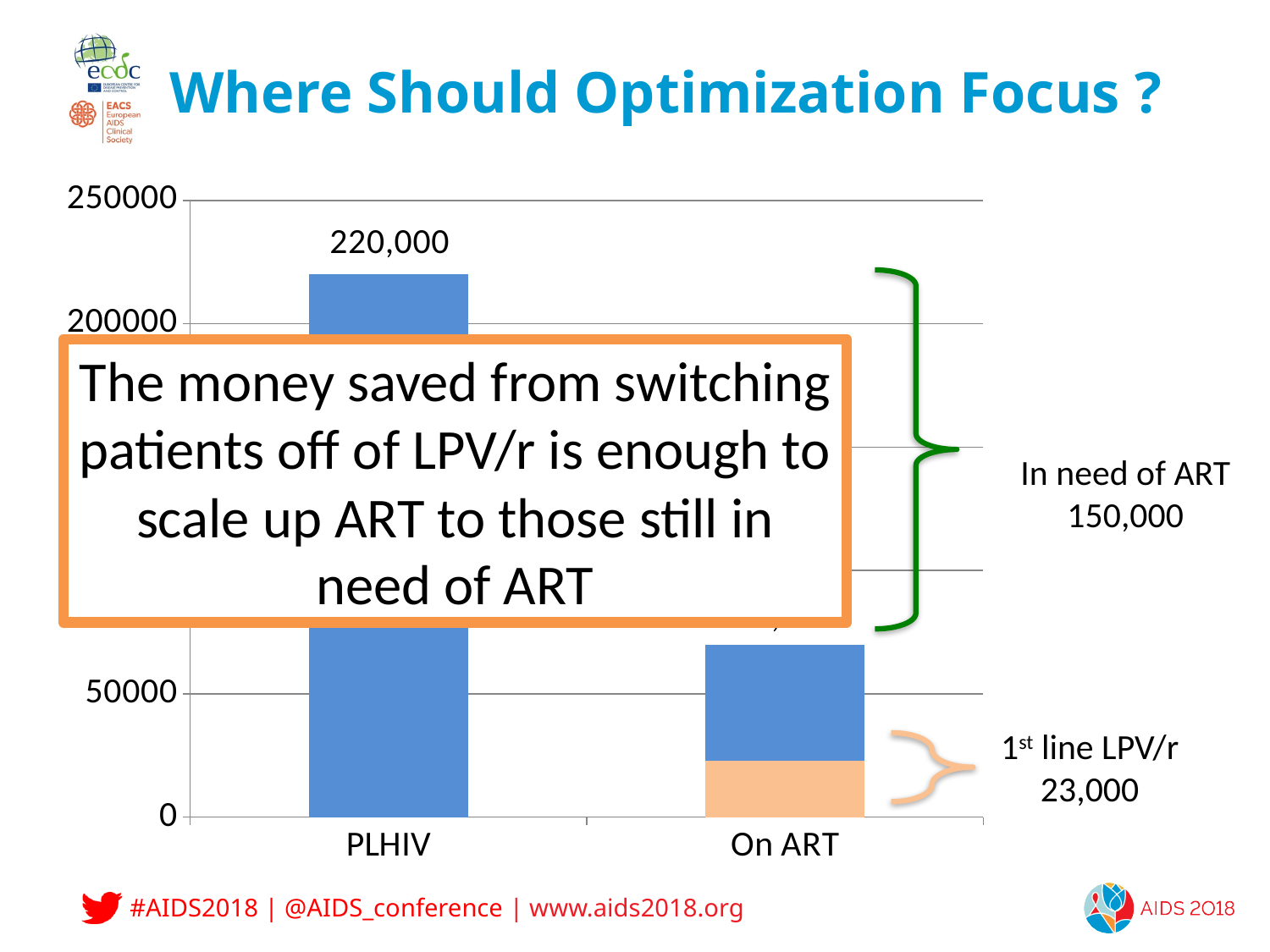
According to the annotation, how many patients are on 1st line LPV/r? 23,000 What is the title of the slide? Where Should Optimization Focus ? Which category has the lowest bar? On ART How many categories are shown on the x axis of the chart? 2 What colour is the segment of the On ART bar that represents 1st line LPV/r? orange What kind of chart is shown on the slide? bar chart Is the total value for On ART greater or less than 100000? less According to the annotation, how many people are in need of ART? 150,000 What is the value shown for PLHIV? 220,000 Which is larger, the bar for PLHIV or the bar for On ART? PLHIV Is the value for PLHIV greater or less than 200000? greater Which category has the highest bar? PLHIV